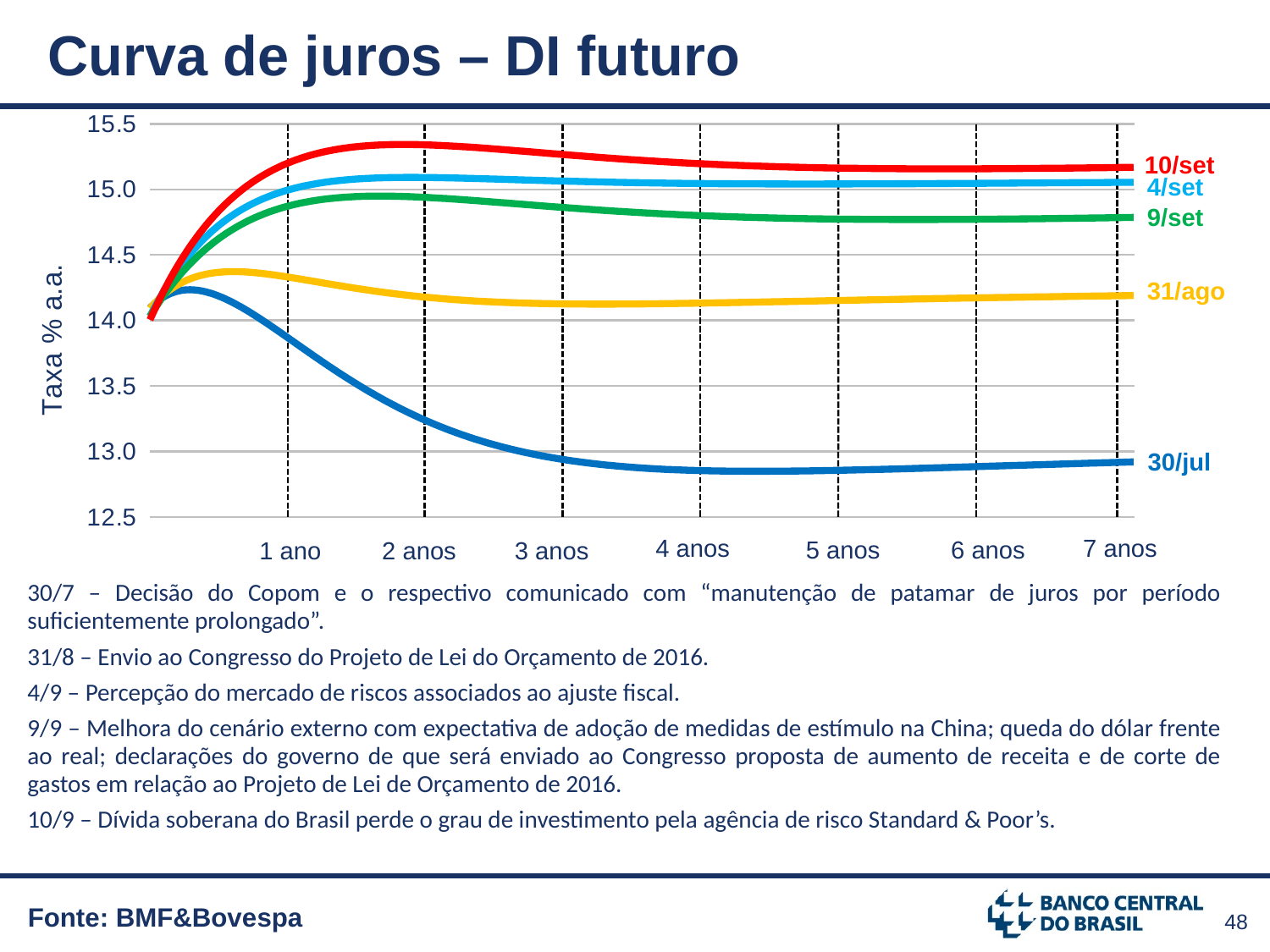
Is the value of the 9/set curve at 5 anos greater or less than 14.5? greater Does the 30/jul curve rise or fall between 1 ano and 4 anos? fall Is the value of the 10/set curve at 2 anos greater or less than 15.0? greater What is the label of the y axis? Taxa % a.a. Is the value of the 31/ago curve at 1 ano greater or less than 14.5? less What kind of chart is shown on the slide? line chart Which curve is the lowest at 7 anos? 30/jul How many series (curves) are plotted on the chart? 5 At 3 anos, which curve is higher: 4/set or 9/set? 4/set Which curve is the highest at 7 anos? 10/set How many maturity points are labelled on the x axis? 7